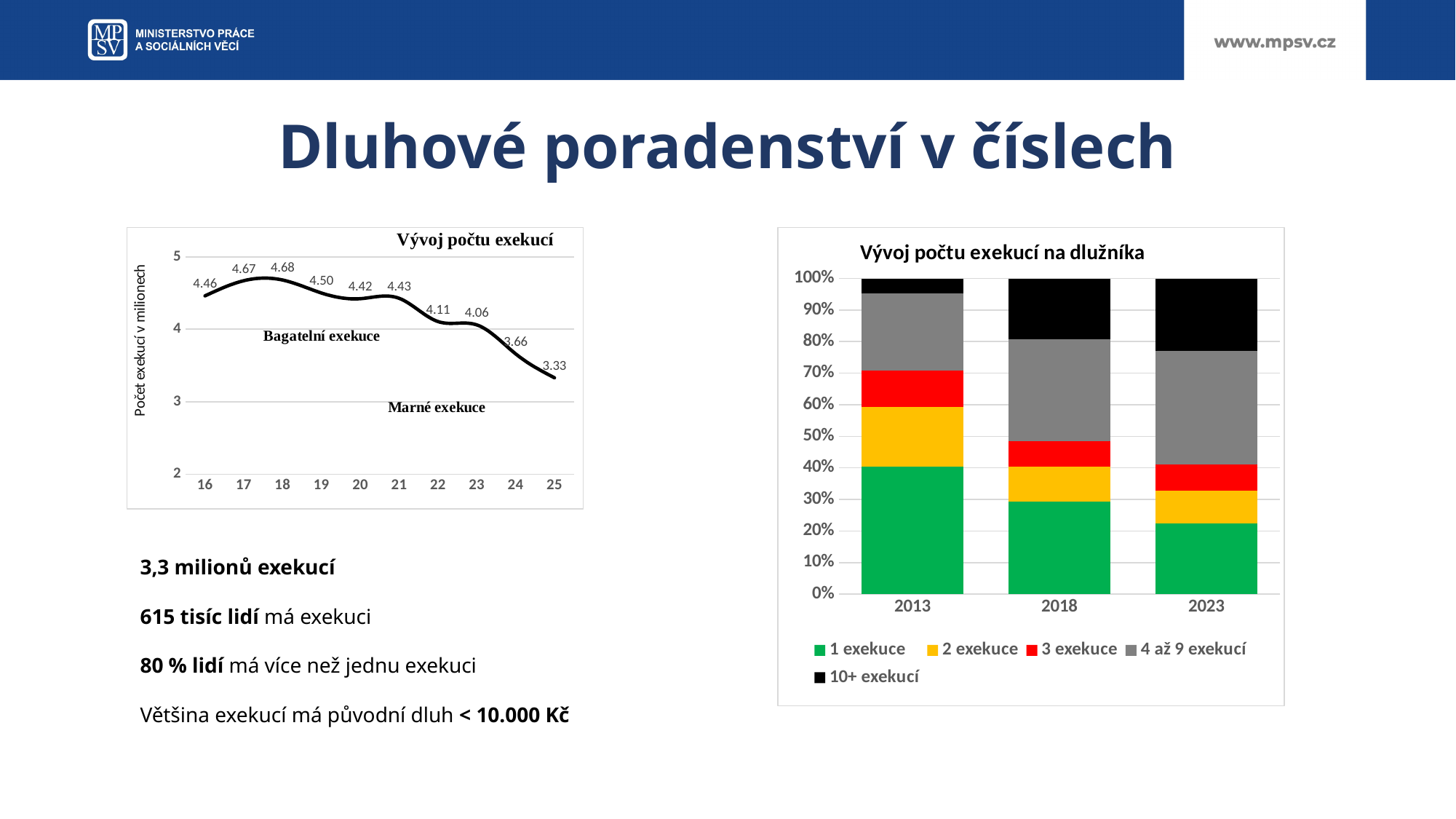
What kind of chart is the one titled 'Vývoj počtu exekucí na dlužníka'? stacked bar chart In the chart titled 'Vývoj počtu exekucí', what is the value for 25? 3.33 In the chart titled 'Vývoj počtu exekucí', what is the value for 18? 4.68 In the chart titled 'Vývoj počtu exekucí', do the values generally rise or fall from 18 to 25? fall In the chart titled 'Vývoj počtu exekucí', which year has the lowest value? 25 In the chart titled 'Vývoj počtu exekucí', which is larger, the value for 19 or the value for 24? 19 In the chart titled 'Vývoj počtu exekucí', which year has the highest value? 18 In the chart titled 'Vývoj počtu exekucí', what is the value for 22? 4.11 In the chart titled 'Vývoj počtu exekucí na dlužníka', is the share of '1 exekuce' in 2023 greater or less than 30%? less In the chart titled 'Vývoj počtu exekucí na dlužníka', how many series does the legend list? 5 In the chart titled 'Vývoj počtu exekucí', what is the difference between the values for 16 and 25? 1.13 In the chart titled 'Vývoj počtu exekucí', how many data points are plotted? 10